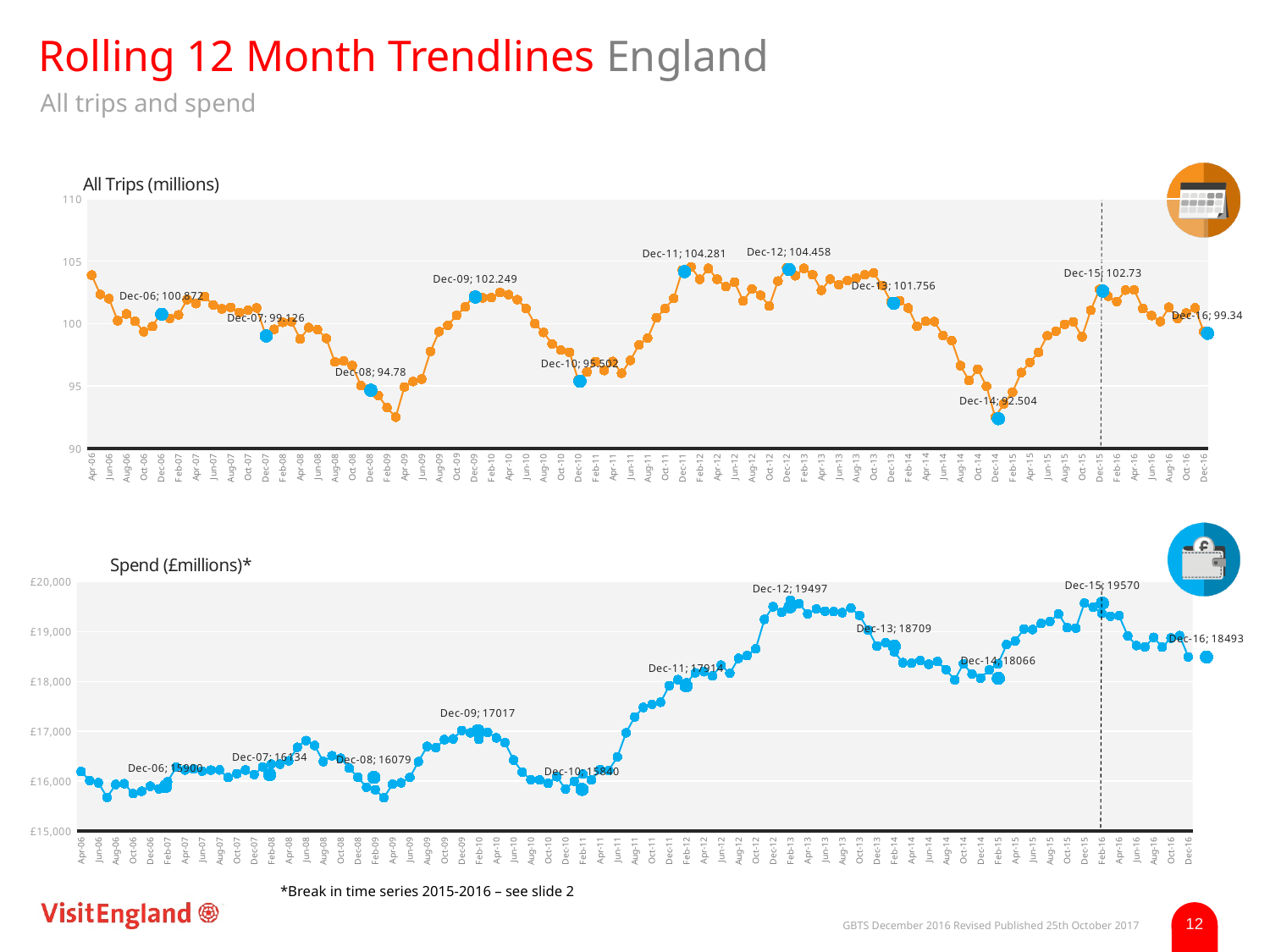
In the Spend (£millions) chart, which is larger, the Dec-12 value or the Dec-13 value? Dec-12 In the All Trips (millions) chart, what is the value labelled for Dec-14? 92.504 In the Spend (£millions) chart, what is the value labelled for Dec-16? 18493 In the All Trips (millions) chart, which labelled December point has the lowest value? Dec-14 What kind of chart is the All Trips (millions) chart? Line chart In the Spend (£millions) chart, what is the difference between the Dec-15 value and the Dec-16 value? 1077 In the All Trips (millions) chart, which labelled December point has the highest value? Dec-12 In the All Trips (millions) chart, what is the value labelled for Dec-12? 104.458 In the Spend (£millions) chart, what is the value labelled for Dec-15? 19570 What does the footnote marked with an asterisk below the Spend chart say? Break in time series 2015-2016 – see slide 2 In the Spend (£millions) chart, is the value for Dec-12 greater or less than £19,000? greater In the All Trips (millions) chart, what is the difference between the Dec-15 value and the Dec-16 value? 3.39